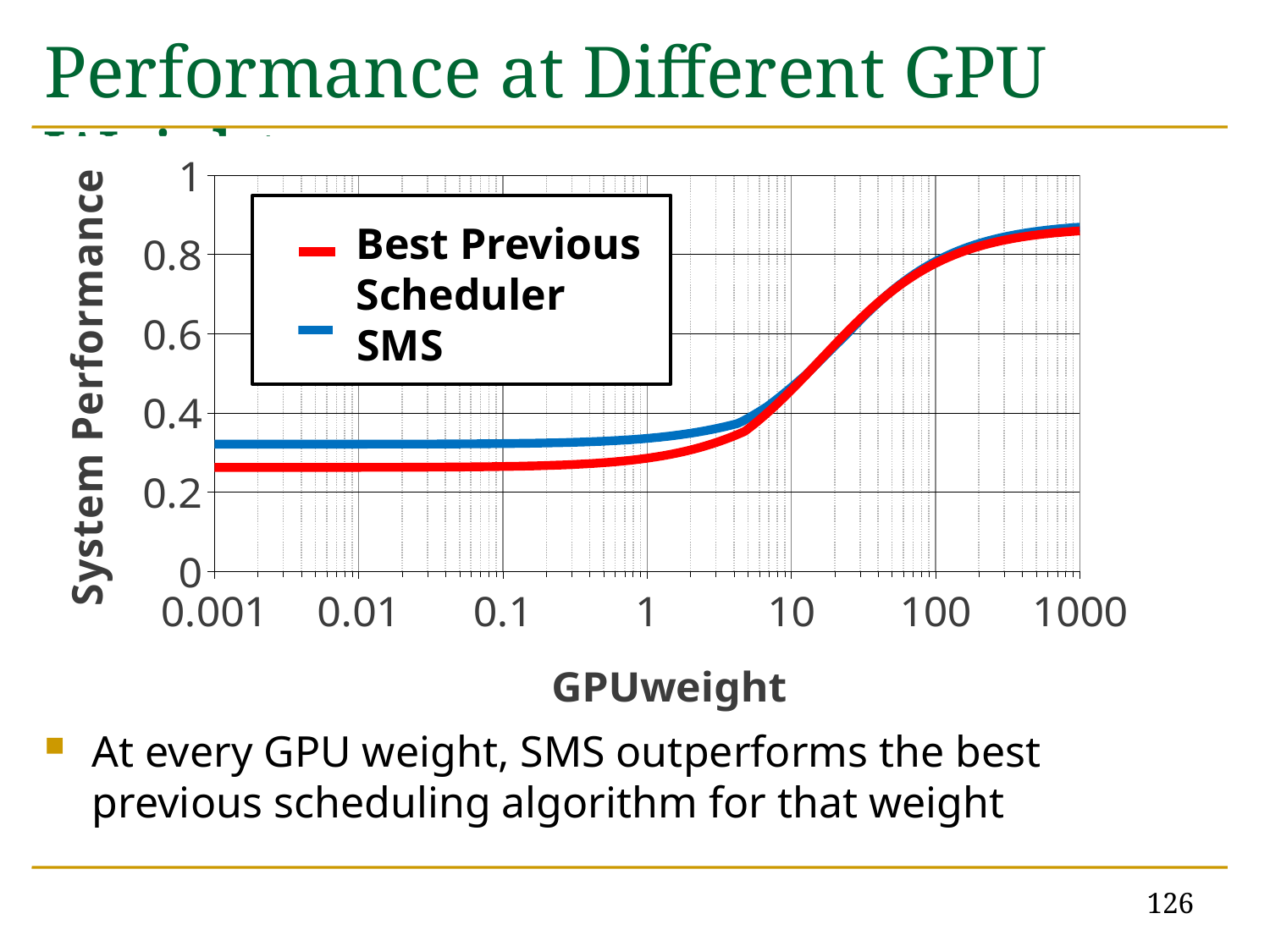
Do the values for SMS rise or fall as GPUweight increases along the x axis? rise What is the label of the x axis of the chart? GPUweight At a GPUweight of 0.01, which series has the lower System Performance, SMS or Best Previous Scheduler? Best Previous Scheduler Which series is drawn in red in the chart? Best Previous Scheduler Is the System Performance for SMS at a GPUweight of 0.001 greater or less than 0.4? less Is the System Performance for Best Previous Scheduler at a GPUweight of 0.001 greater or less than 0.2? greater At a GPUweight of 0.001, which series has the higher System Performance, SMS or Best Previous Scheduler? SMS Is the System Performance for SMS at a GPUweight of 1000 greater or less than 0.8? greater What kind of chart is shown on the slide? line chart Do the values for Best Previous Scheduler rise or fall as GPUweight increases along the x axis? rise How many series does the chart's legend list? 2